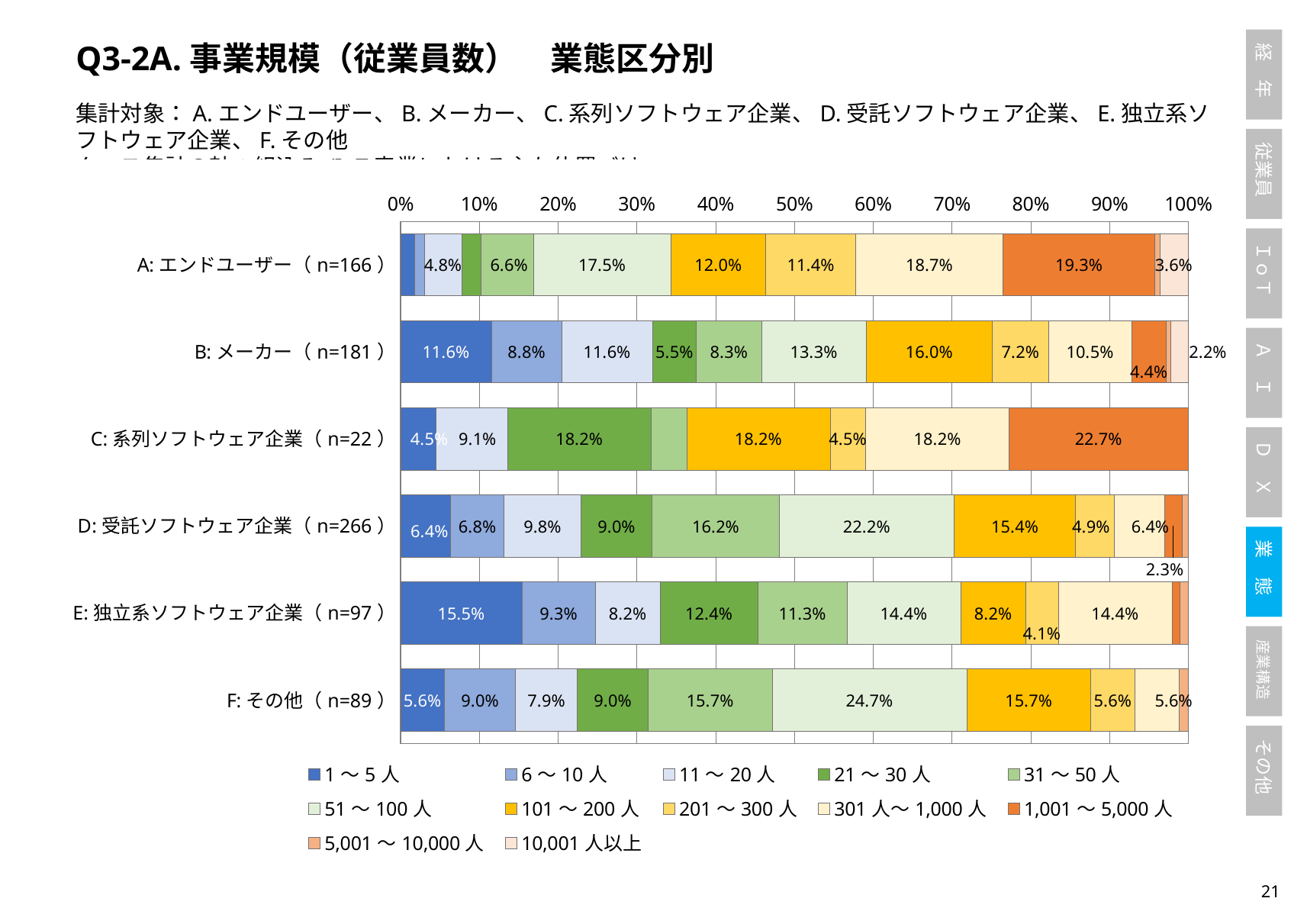
What is the share of 31～50人 for D: 受託ソフトウェア企業? 16.2% What is the share of 1,001～5,000人 for C: 系列ソフトウェア企業? 22.7% What is the share of 1～5人 for E: 独立系ソフトウェア企業? 15.5% Which business category has the highest share of 1～5人? E: 独立系ソフトウェア企業 What is the share of 51～100人 for F: その他? 24.7% What is the difference between the 1,001～5,000人 share for A: エンドユーザー and for B: メーカー? 14.9 percentage points Which is larger: the 51～100人 share for D: 受託ソフトウェア企業 or for F: その他? F: その他 What is the sample size (n) shown for D: 受託ソフトウェア企業? 266 How many series does the legend list? 12 How many business categories (bars) are plotted in the chart? 6 What is the share of 101～200人 for B: メーカー? 16.0% What kind of chart is shown on the slide? Stacked bar chart